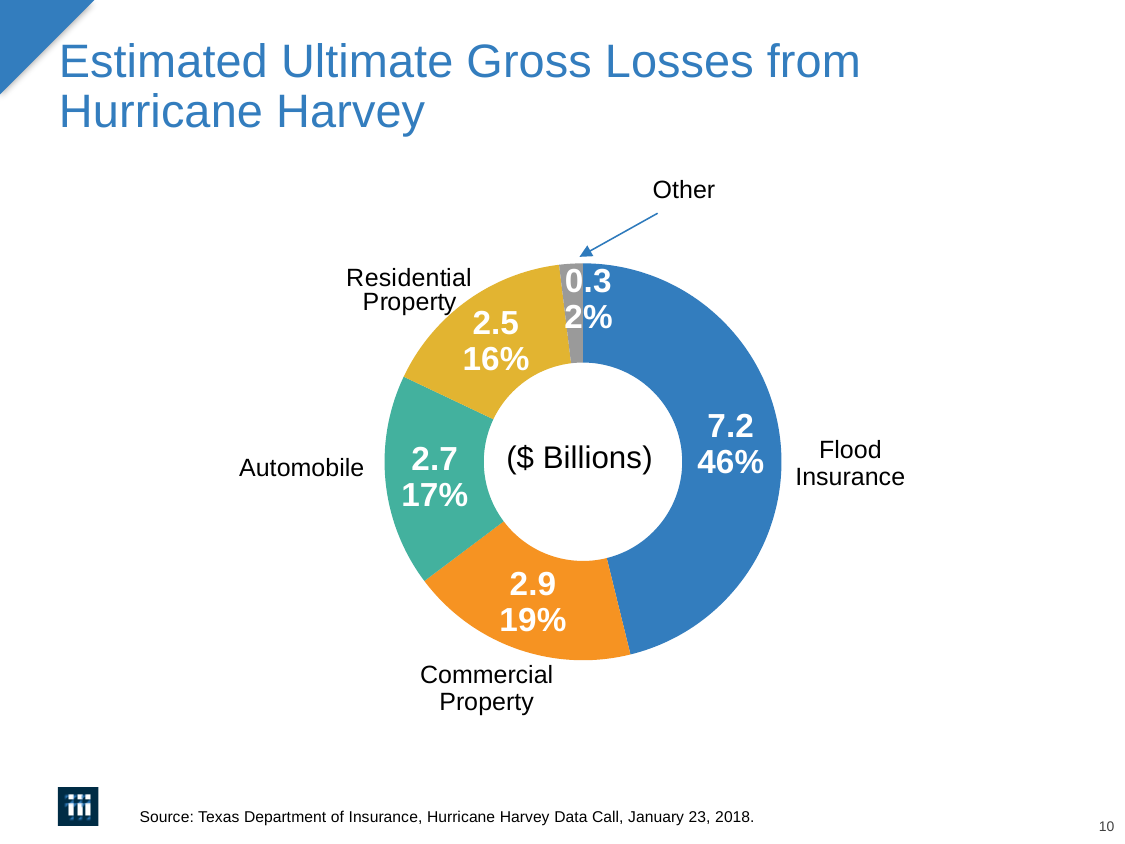
What is the difference between the Flood Insurance value and the Commercial Property value? 4.3 What is the estimated ultimate gross loss for Flood Insurance? 7.2 Which is larger, the value for Automobile or the value for Residential Property? Automobile What is the value shown for Automobile? 2.7 Which category has the smallest estimated loss? Other What share of the total does the Other category represent? 2% How many categories are shown in the chart? 5 What kind of chart is shown on the slide? Pie chart (donut) What unit are the values in the chart expressed in? $ Billions Which category has the largest estimated loss? Flood Insurance What percentage of the total is Residential Property? 16% What share of the estimated losses is attributed to Commercial Property? 19%